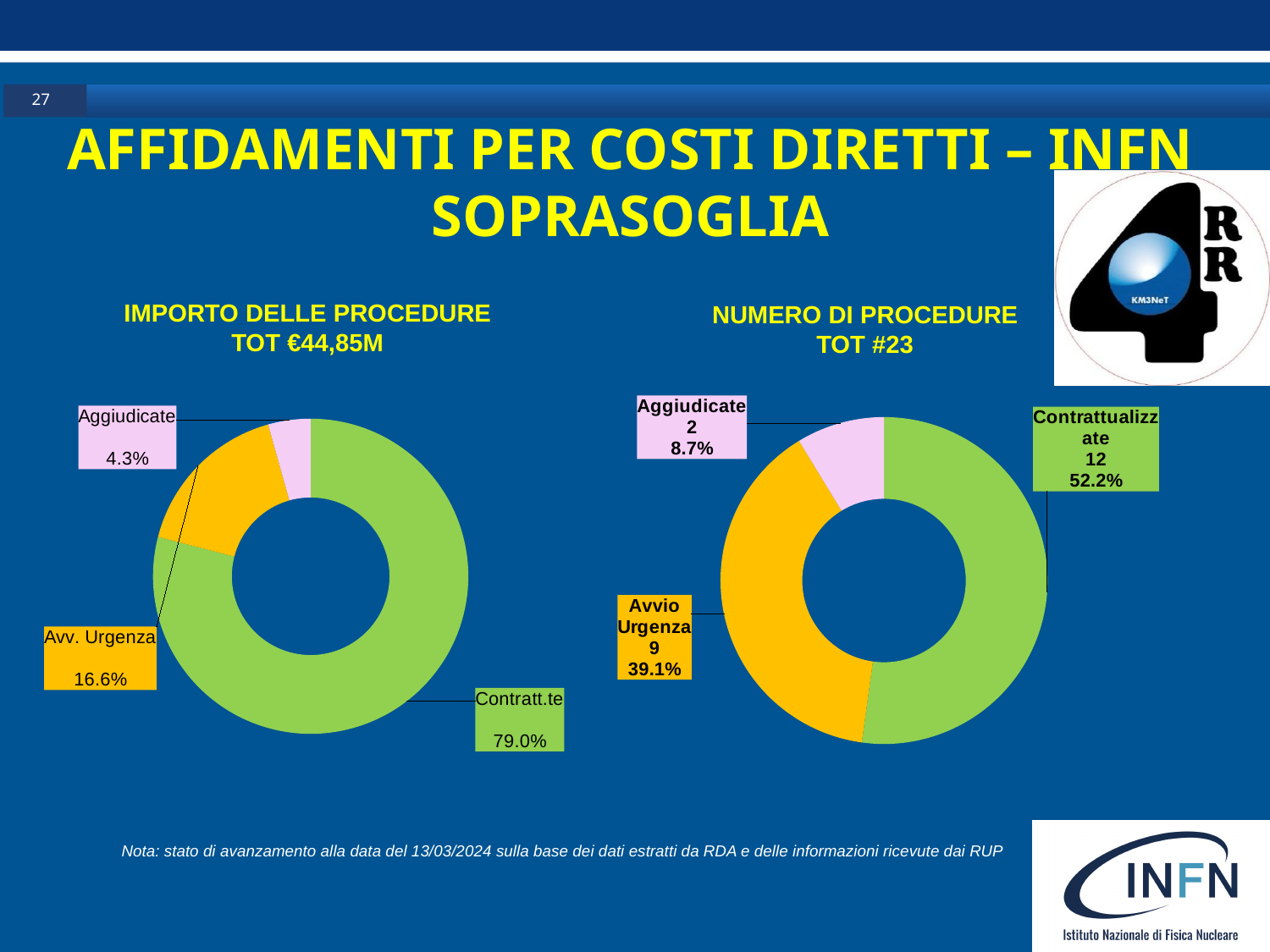
In the 'NUMERO DI PROCEDURE' chart, how many procedures are Avvio Urgenza? 9 In the 'NUMERO DI PROCEDURE' chart, which is larger: Avvio Urgenza or Aggiudicate? Avvio Urgenza In the 'IMPORTO DELLE PROCEDURE' chart, which category has the smallest share? Aggiudicate In the 'IMPORTO DELLE PROCEDURE' chart, what share does Aggiudicate have? 4.3% How many categories does the 'NUMERO DI PROCEDURE' chart show? 3 In the 'NUMERO DI PROCEDURE' chart, what is the difference between the number of Contrattualizzate and Avvio Urgenza procedures? 3 In the 'NUMERO DI PROCEDURE' chart, how many procedures are Contrattualizzate? 12 In the 'IMPORTO DELLE PROCEDURE' chart, what share does Contratt.te have? 79.0% In the 'NUMERO DI PROCEDURE' chart, what share does Aggiudicate have? 8.7% In the 'IMPORTO DELLE PROCEDURE' chart, which category has the largest share? Contratt.te What type of chart is the 'IMPORTO DELLE PROCEDURE' chart? Doughnut chart